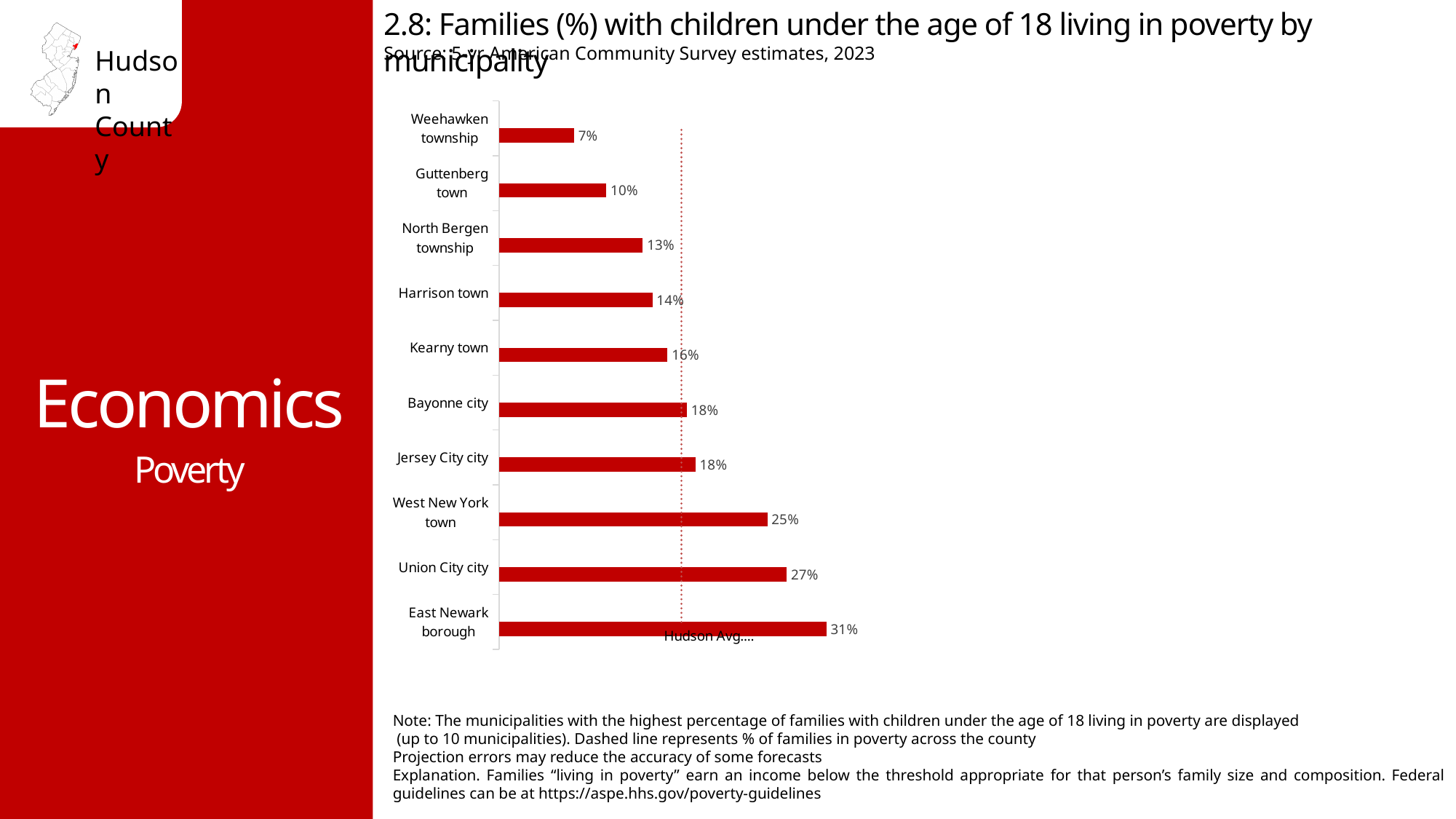
Which municipality has the highest percentage of families with children under 18 living in poverty? East Newark borough What does the dashed vertical line in the chart represent? Hudson Avg. (% of families in poverty across the county) What is the value for West New York town? 25% What is the difference between the values for East Newark borough and Weehawken township? 24% Which municipality has the lowest percentage of families with children under 18 living in poverty? Weehawken township What is the value for Weehawken township? 7% What kind of chart is shown on the slide? Bar chart How many municipalities are shown in the chart? 10 What is the value for East Newark borough? 31% What is the value for Kearny town? 16% What is the difference between the values for Union City city and Guttenberg town? 17% Which is larger, the value for Harrison town or the value for North Bergen township? Harrison town